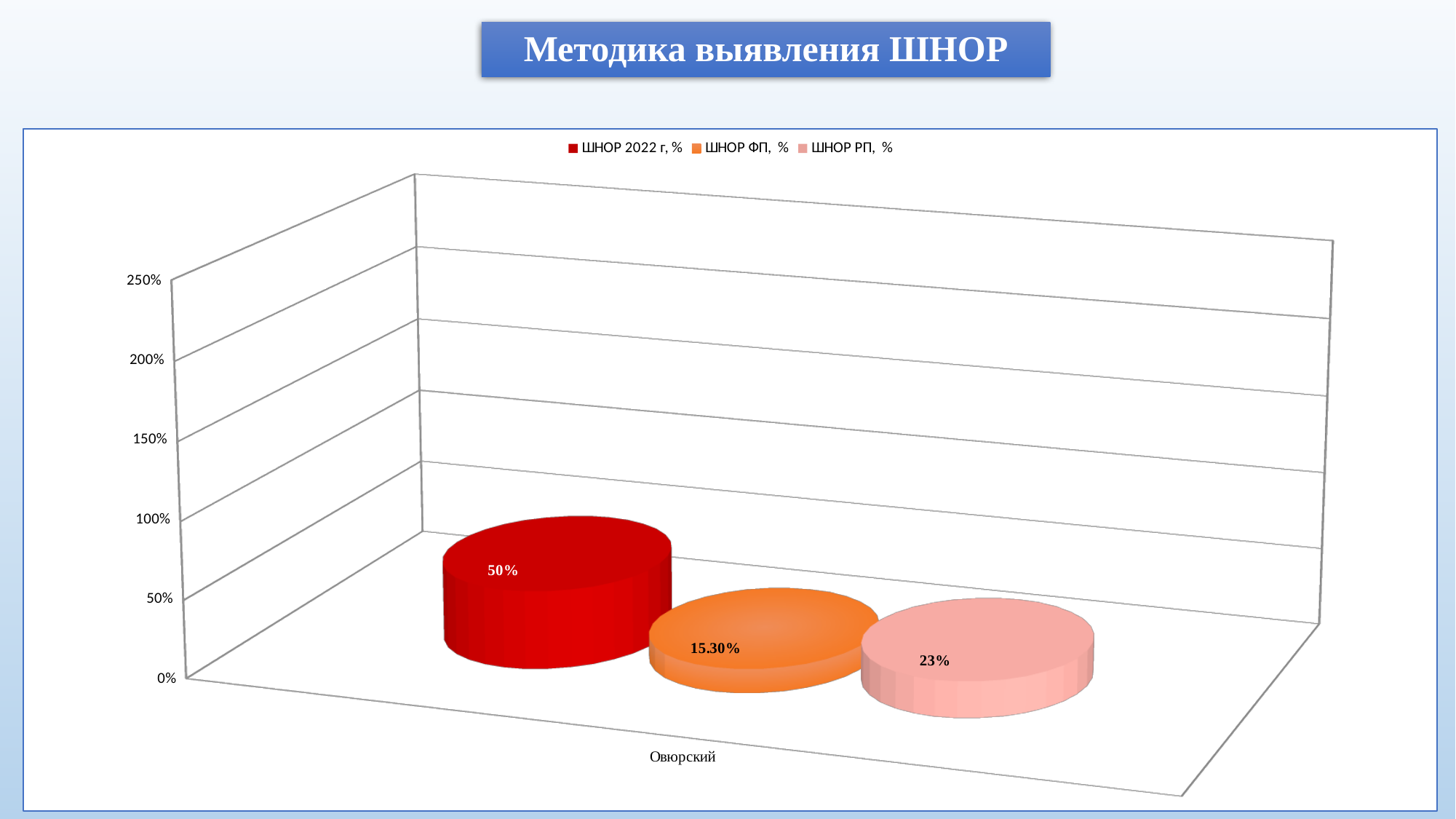
What is the value of ШНОР РП, % for Овюрский? 23% How many series does the legend list? 3 Which is larger for Овюрский: ШНОР ФП, % or ШНОР РП, %? ШНОР РП, % What kind of chart is shown on the slide? bar chart What is the value of ШНОР ФП, % for Овюрский? 15.30% Which series has the highest value for Овюрский? ШНОР 2022 г, % Which series has the lowest value for Овюрский? ШНОР ФП, % Is the value of ШНОР 2022 г, % for Овюрский greater or less than 100%? less What is the difference between the ШНОР 2022 г, % value and the ШНОР РП, % value for Овюрский? 27% How many categories are shown on the x axis? 1 What is the value of ШНОР 2022 г, % for Овюрский? 50% What is the difference between the ШНОР РП, % value and the ШНОР ФП, % value for Овюрский? 7.70%